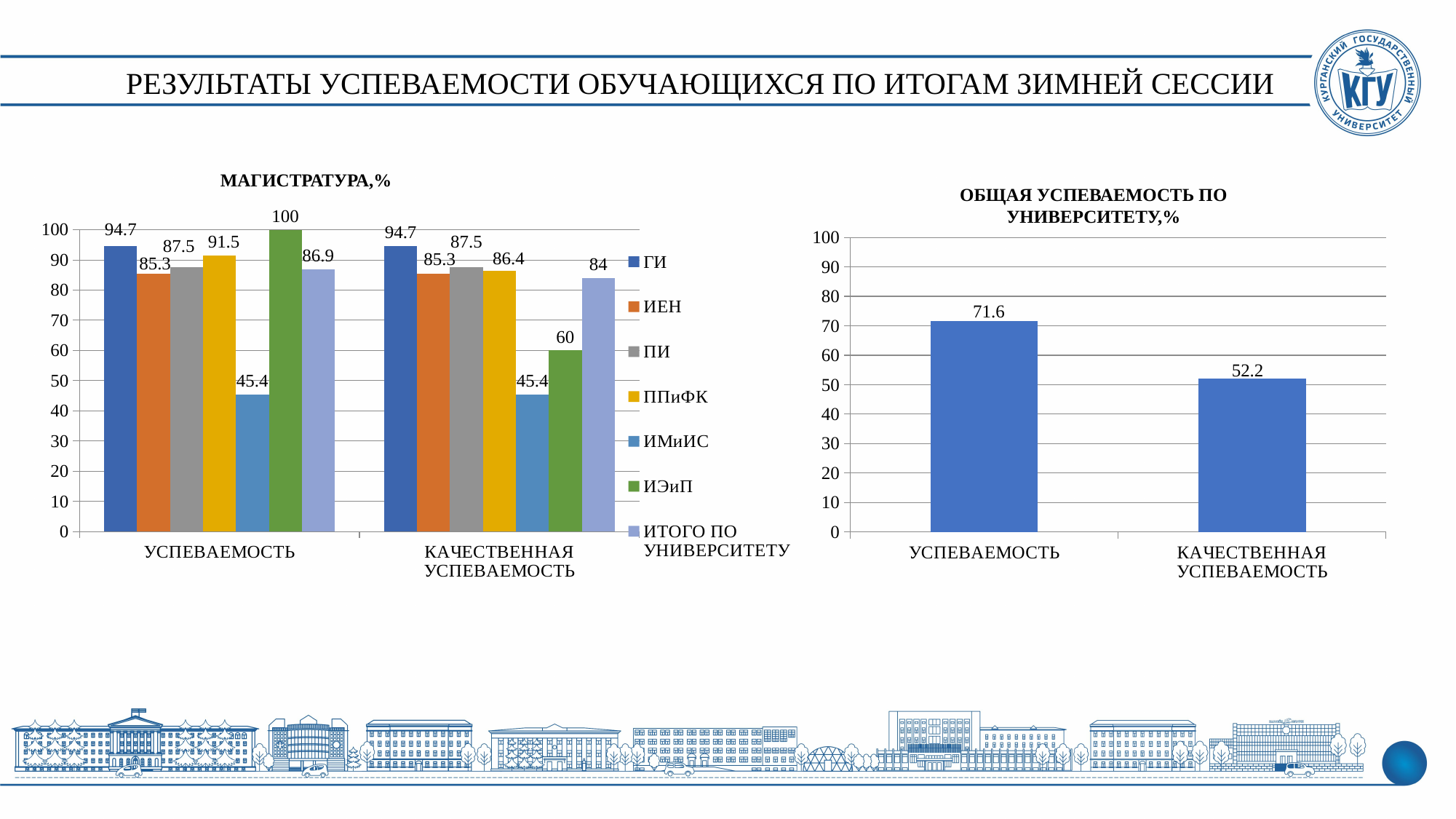
In the МАГИСТРАТУРА,% chart, which series has the highest value in the КАЧЕСТВЕННАЯ УСПЕВАЕМОСТЬ category? ГИ In the МАГИСТРАТУРА,% chart, what is the value for ИЭиП in the УСПЕВАЕМОСТЬ category? 100 How many series does the legend of the МАГИСТРАТУРА,% chart list? 7 What kind of chart is the МАГИСТРАТУРА,% chart? Bar chart In the ОБЩАЯ УСПЕВАЕМОСТЬ ПО УНИВЕРСИТЕТУ,% chart, what is the value for УСПЕВАЕМОСТЬ? 71.6 In the МАГИСТРАТУРА,% chart, what colour are the ИЭиП bars? Green How many categories are shown on the x axis of the ОБЩАЯ УСПЕВАЕМОСТЬ ПО УНИВЕРСИТЕТУ,% chart? 2 In the МАГИСТРАТУРА,% chart, what is the difference between the ИЭиП values for УСПЕВАЕМОСТЬ and КАЧЕСТВЕННАЯ УСПЕВАЕМОСТЬ? 40 In the МАГИСТРАТУРА,% chart, what is the value for ППиФК in the КАЧЕСТВЕННАЯ УСПЕВАЕМОСТЬ category? 86.4 In the МАГИСТРАТУРА,% chart, which is larger in the УСПЕВАЕМОСТЬ category: ППиФК or ИЕН? ППиФК In the МАГИСТРАТУРА,% chart, which series has the lowest value in the УСПЕВАЕМОСТЬ category? ИМиИС In the ОБЩАЯ УСПЕВАЕМОСТЬ ПО УНИВЕРСИТЕТУ,% chart, what is the difference between УСПЕВАЕМОСТЬ and КАЧЕСТВЕННАЯ УСПЕВАЕМОСТЬ? 19.4